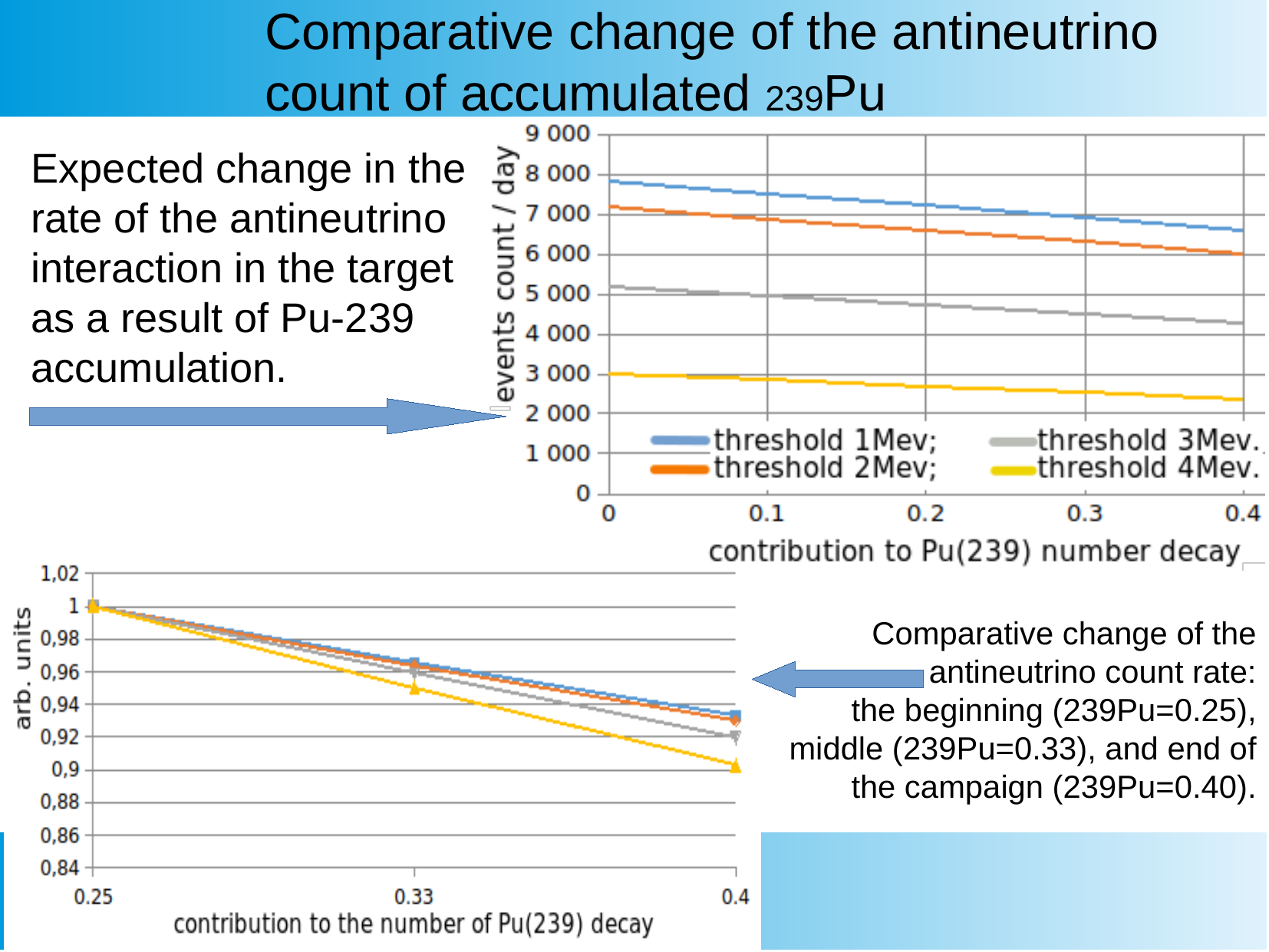
In the bottom-left chart, is the value of the yellow series at x = 0.4 greater or less than 0.92? less What type of chart is the top-right chart with the y-axis 'events count / day'? line chart In the bottom-left chart, what value do all the series have at x = 0.25? 1 In the top-right chart, which series has the lowest event count across the x axis? threshold 4Mev In the top-right chart, is the value for threshold 4Mev at x = 0.4 greater or less than 3 000? less In the top-right chart, is the value for threshold 1Mev at x = 0 greater or less than 7 000? greater In the top-right chart, what is the label of the x axis? contribution to Pu(239) number decay In the top-right chart, at x = 0.4, which is larger: threshold 1Mev or threshold 3Mev? threshold 1Mev In the top-right chart, which series has the highest event count across the x axis? threshold 1Mev In the top-right chart, how many series does the legend list? 4 In the bottom-left chart, how many x-axis points are plotted? 3 In the top-right chart, do the event counts rise or fall as the contribution to Pu(239) number decay increases? fall